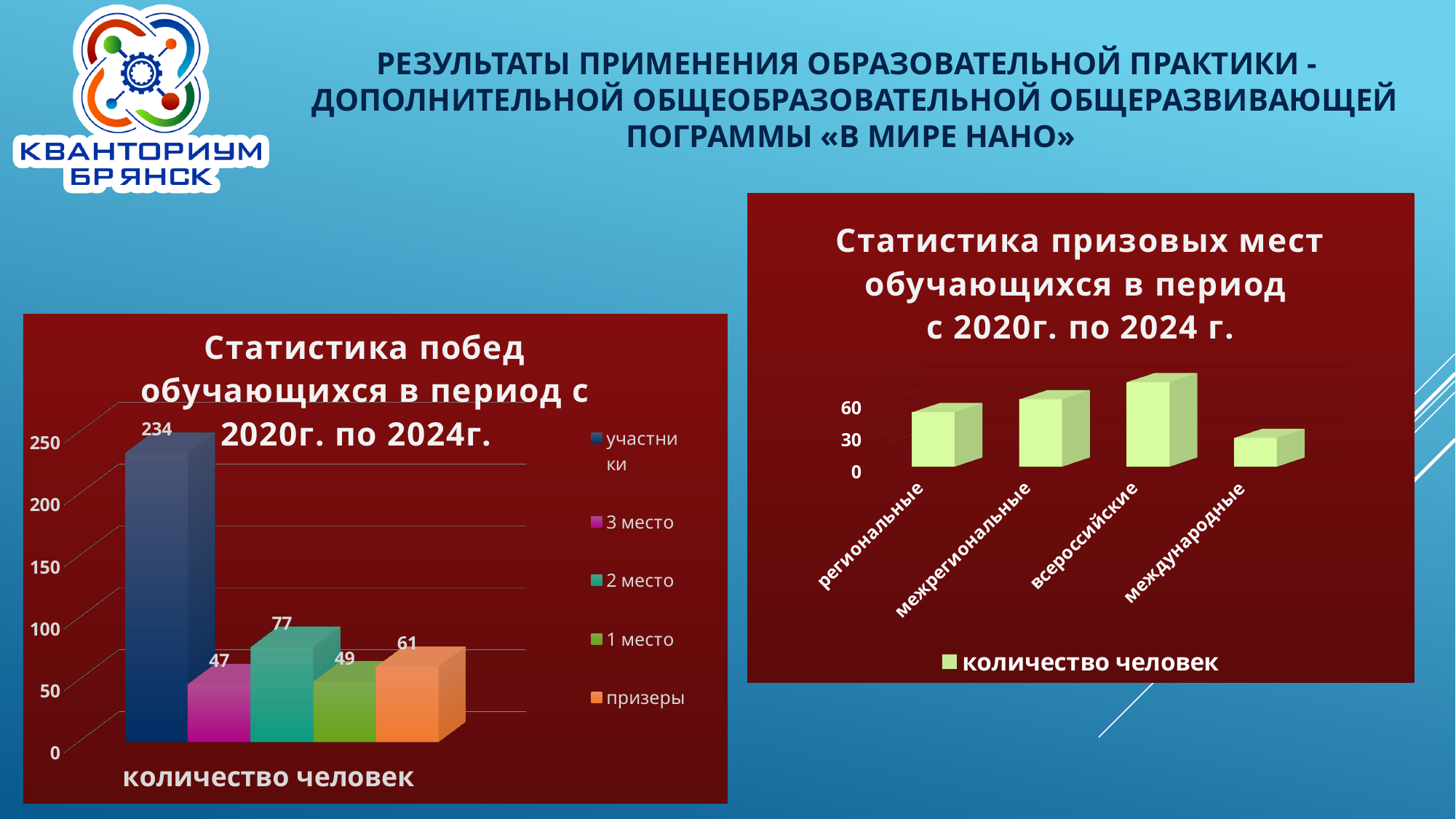
In the left chart 'Статистика побед обучающихся', what is the difference between 2 место and 1 место? 28 In the left chart 'Статистика побед обучающихся', what is the value for 2 место? 77 In the left chart 'Статистика побед обучающихся', which series has the highest value? участники In the left chart 'Статистика побед обучающихся в период с 2020г. по 2024г.', what is the value for участники? 234 In the left chart 'Статистика побед обучающихся', which is larger: призеры or 1 место? призеры In the left chart 'Статистика побед обучающихся', which series has the lowest value? 3 место How many series does the legend of the left chart 'Статистика побед обучающихся' list? 5 In the right chart 'Статистика призовых мест обучающихся', is the value for всероссийские greater or less than 60? greater In the right chart 'Статистика призовых мест обучающихся', which category has the highest value? всероссийские In the left chart 'Статистика побед обучающихся', what is the value for призеры? 61 In the right chart 'Статистика призовых мест обучающихся', which category has the lowest value? международные How many categories are shown in the right chart 'Статистика призовых мест обучающихся'? 4